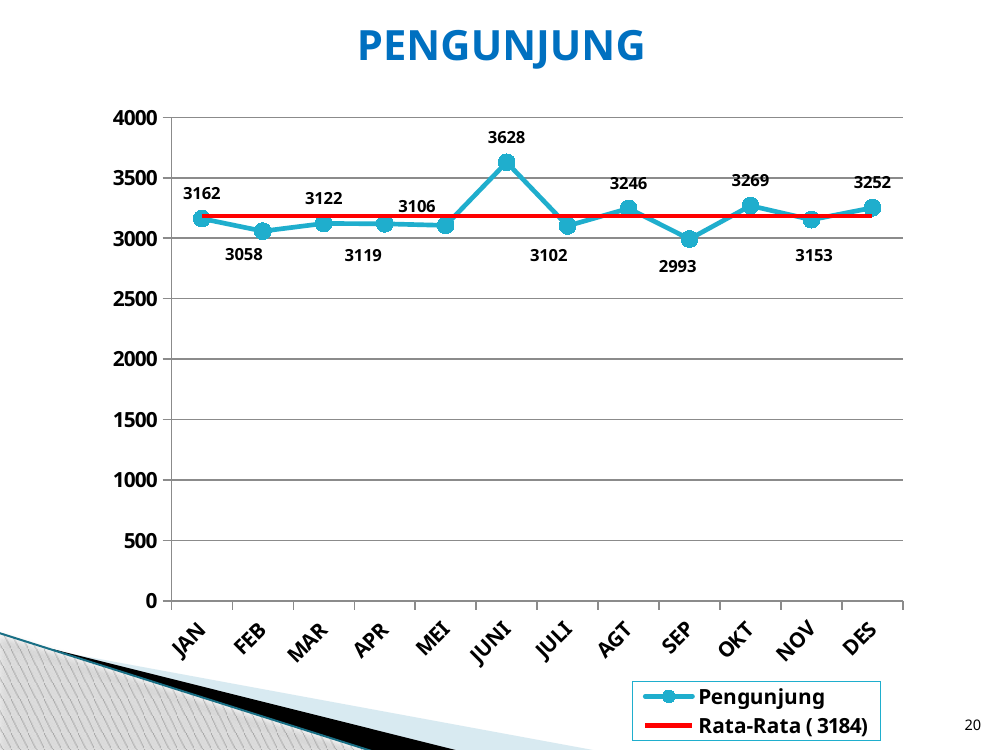
What is the value for OKT in the Pengunjung series? 3269 What is the value for JUNI in the Pengunjung series? 3628 What kind of chart is shown on the slide? line chart Which month has the highest Pengunjung value? JUNI What is the difference between the Pengunjung values for JUNI and SEP? 635 How many series does the legend list? 2 Which is larger, the Pengunjung value for AGT or for JULI? AGT How many months are plotted on the x axis? 12 Is the Pengunjung value for JUNI greater or less than 3500? greater What is the value for SEP in the Pengunjung series? 2993 What is the difference between the Pengunjung values for OKT and NOV? 116 Which month has the lowest Pengunjung value? SEP